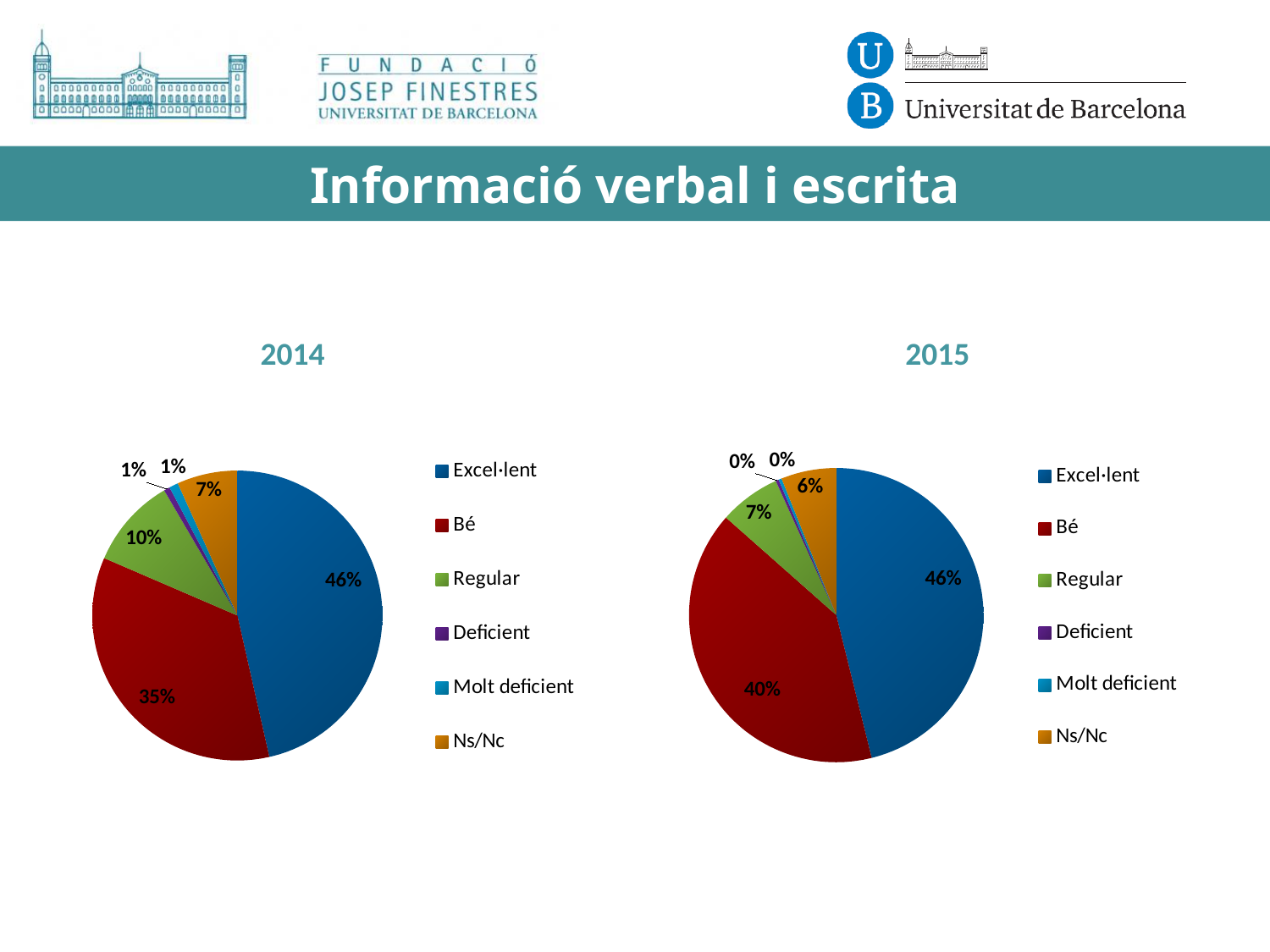
In the 2015 chart, what is the difference between the Excel·lent and Bé shares? 6% In the 2015 chart, what share does Ns/Nc have? 6% In the 2014 chart, which category has the largest slice? Excel·lent In the 2014 chart, which is larger, Regular or Ns/Nc? Regular In the 2014 chart, what share does Regular have? 10% What is the title of the chart on the right? 2015 In the 2014 chart, what is the difference between the Excel·lent and Bé shares? 11% What kind of chart is the 2015 chart? Pie chart How many categories does the legend of the 2014 chart list? 6 In the 2015 chart, what share does Bé have? 40% In the 2015 chart, which category has the largest slice? Excel·lent In the 2014 chart, what share does Excel·lent have? 46%